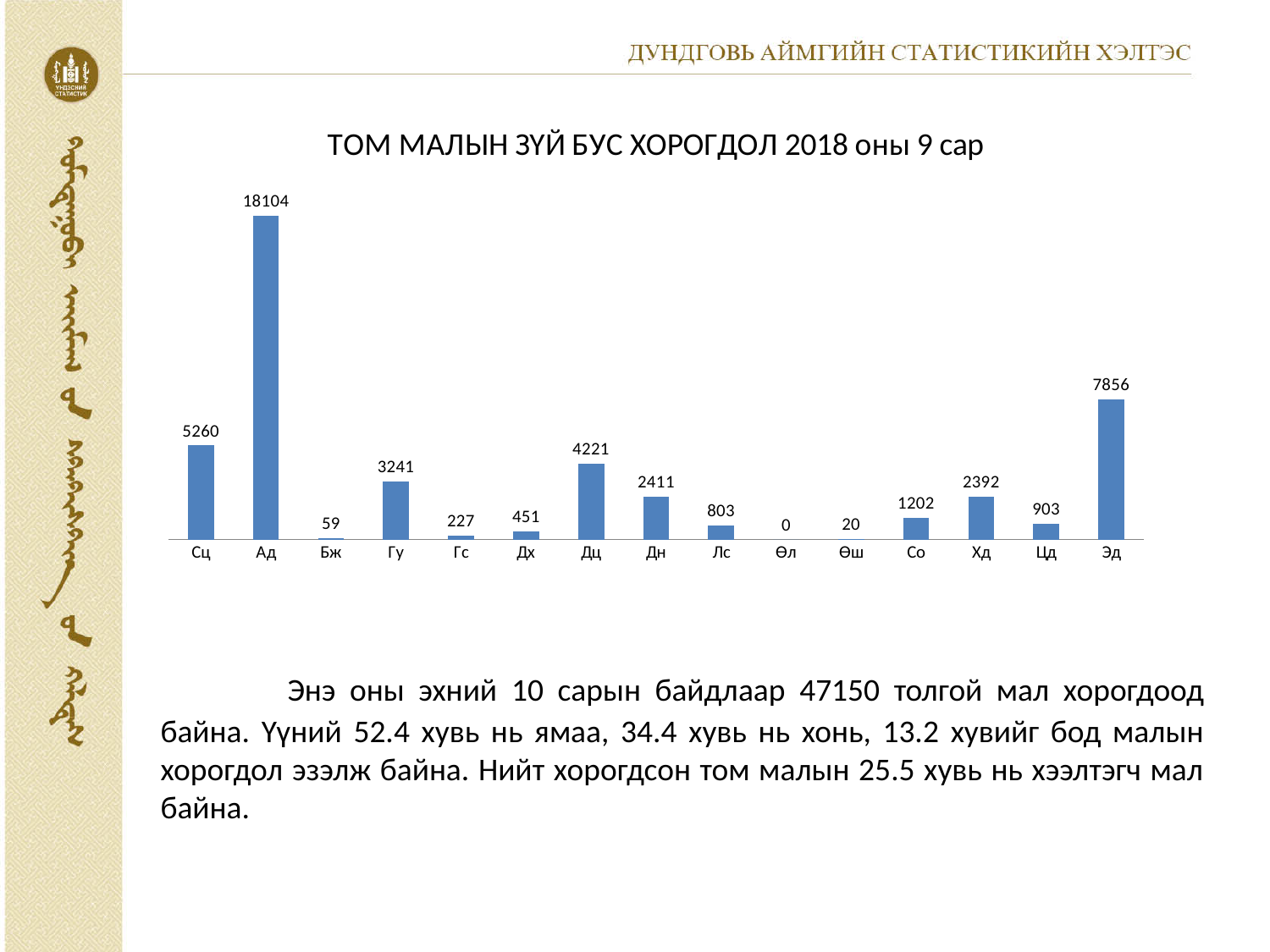
Which category has the highest value? Ад What is the title of the chart? ТОМ МАЛЫН ЗҮЙ БУС ХОРОГДОЛ 2018 оны 9 сар How many categories are shown on the x axis? 15 What is the value for Ад? 18104 Which is larger, the value for Гу or the value for Дн? Гу What is the value for Гс? 227 Which category has the lowest value? Өл What is the difference between the values for Ад and Эд? 10248 What is the difference between the values for Сц and Дц? 1039 What is the value for Эд? 7856 What kind of chart is shown on the slide? Bar chart What is the value for Өш? 20